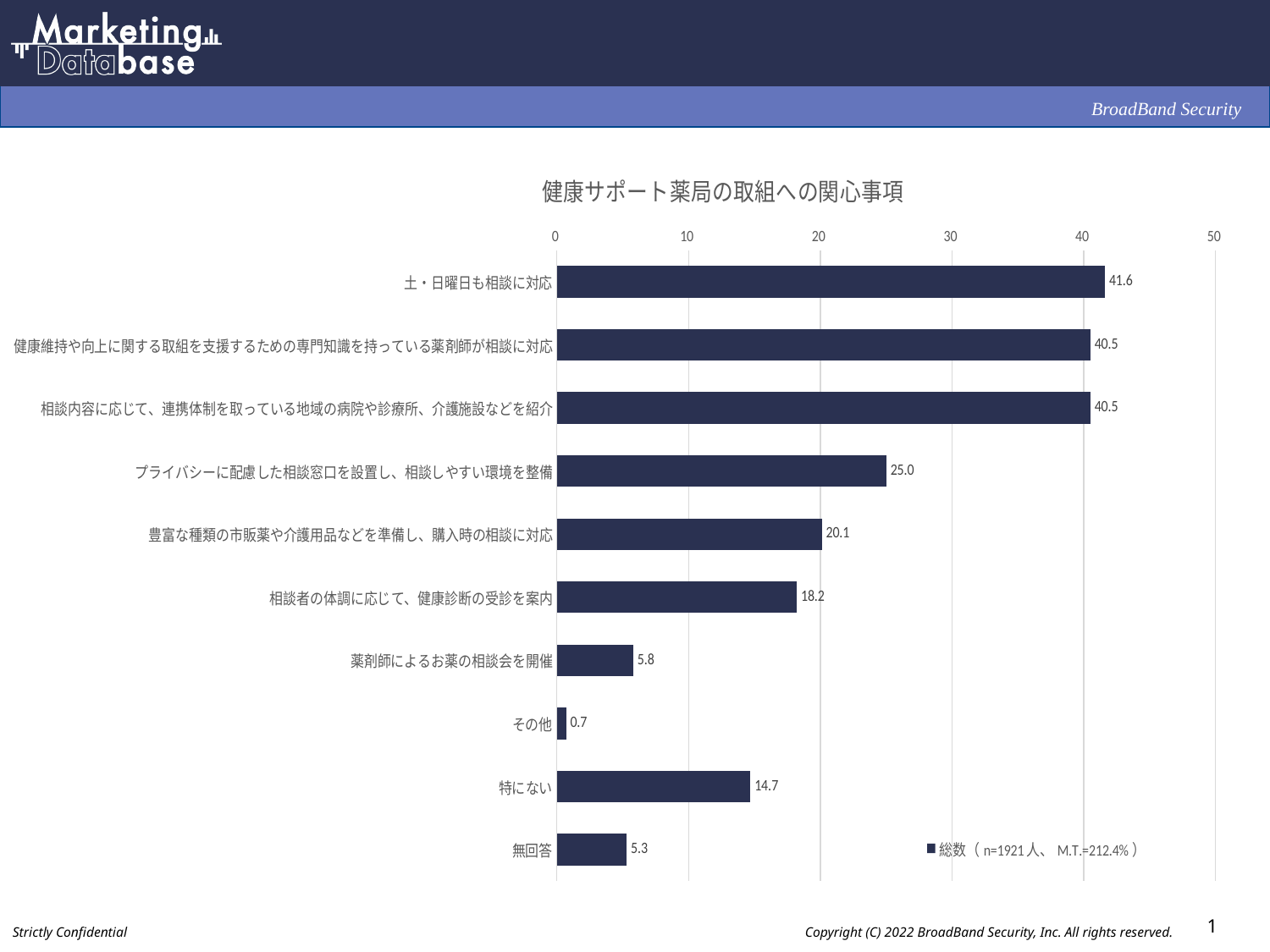
What is the value for 特にない? 14.7 How many categories are shown in the chart? 10 What is the value for 土・日曜日も相談に対応? 41.6 Which category has the lowest value? その他 What is the title of the chart? 健康サポート薬局の取組への関心事項 What is the value for プライバシーに配慮した相談窓口を設置し、相談しやすい環境を整備? 25.0 What kind of chart is shown on the slide? bar chart Which is larger, the value for 特にない or the value for 薬剤師によるお薬の相談会を開催? 特にない Which category has the highest value? 土・日曜日も相談に対応 Is the value for 相談者の体調に応じて、健康診断の受診を案内 greater or less than 20? less What is the difference between the values for 特にない and 無回答? 9.4 What is the difference between the values for 土・日曜日も相談に対応 and プライバシーに配慮した相談窓口を設置し、相談しやすい環境を整備? 16.6